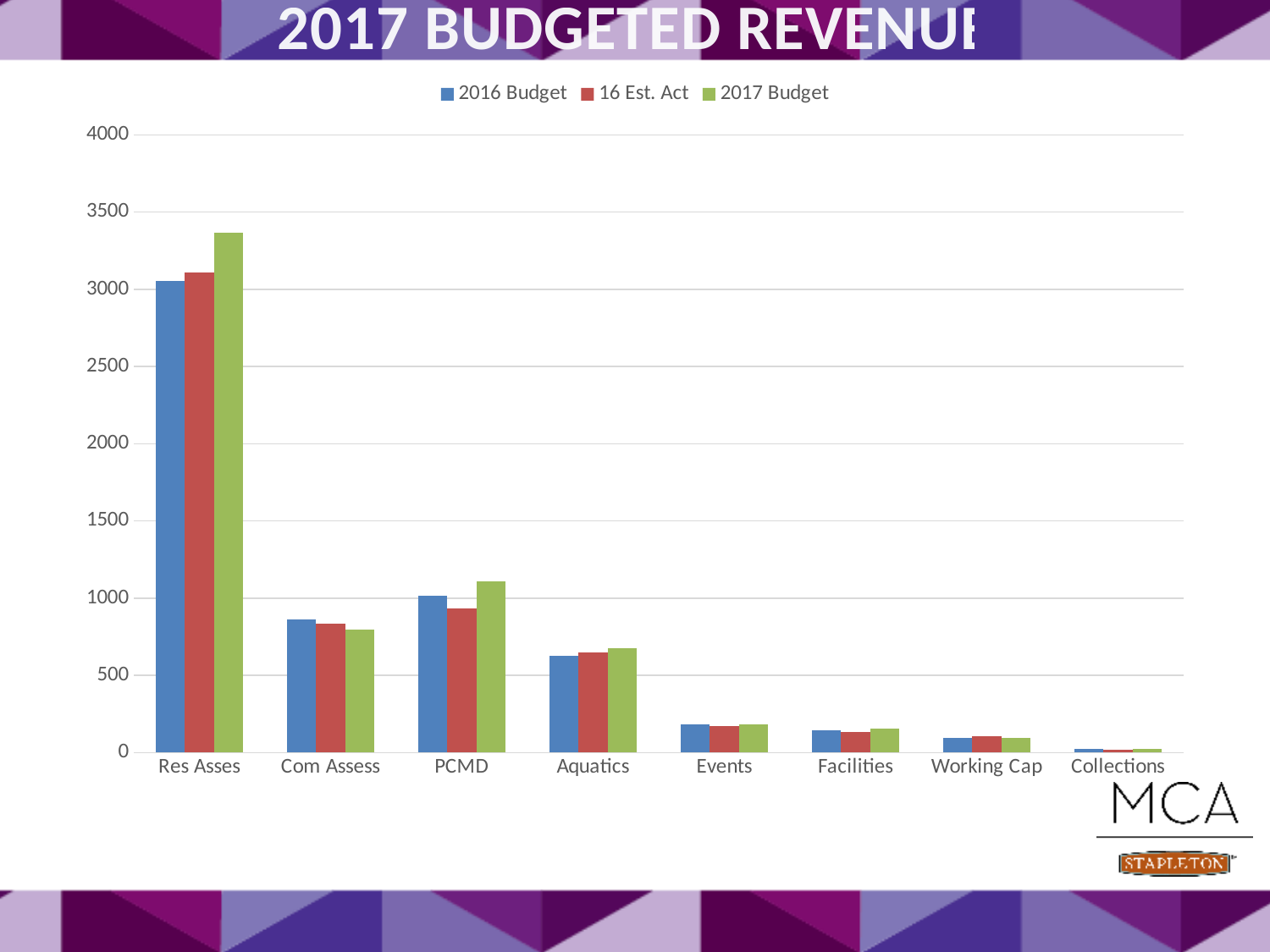
Is the 2017 Budget value for Events greater or less than 500? less What kind of chart is shown on the slide? bar chart Which colour represents the 2017 Budget series in the legend? green Is the 2017 Budget value for Res Asses greater or less than 3000? greater For Res Asses, which is larger: the 2016 Budget value or the 2017 Budget value? 2017 Budget Is the 2016 Budget value for Com Assess greater or less than 500? greater How many series does the chart's legend list? 3 Which category has the highest values in the chart? Res Asses How many categories are shown along the x axis of the chart? 8 Which category has the lowest values in the chart? Collections